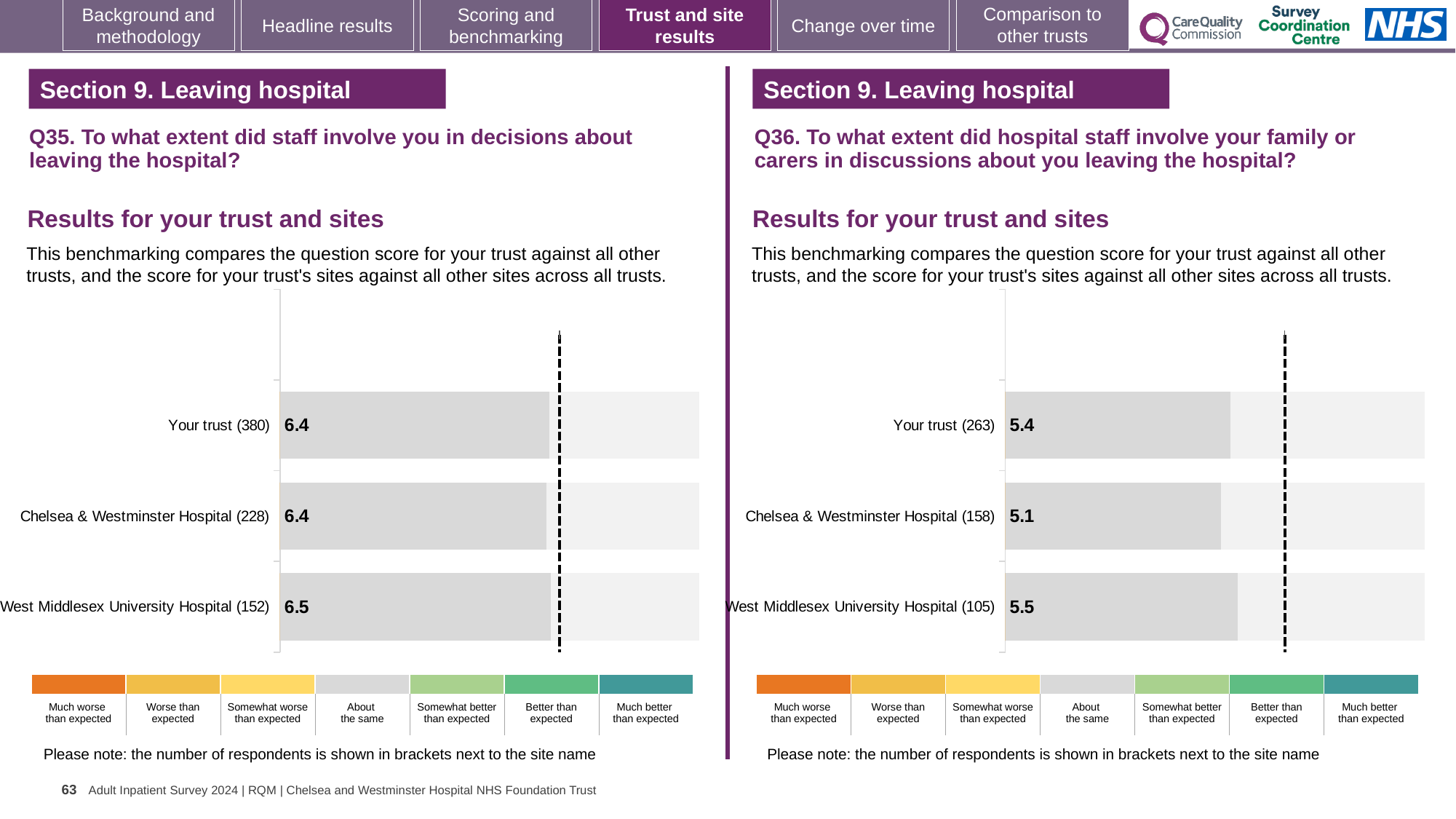
On the Q35 chart (left), which site or trust has the highest score? West Middlesex University Hospital On the Q36 chart (right), what is the score for Chelsea & Westminster Hospital? 5.1 On the Q35 chart (left), what is the score for West Middlesex University Hospital? 6.5 On the Q35 chart (left), what is the score for Your trust? 6.4 On the Q36 chart (right), which site or trust has the highest score? West Middlesex University Hospital On the Q36 chart (right), what is the score for Your trust? 5.4 On the Q35 chart (left), how many respondents are shown in brackets for Your trust? 380 How many bars are plotted on the Q35 chart (left)? 3 On the Q36 chart (right), which has the larger score: Your trust or Chelsea & Westminster Hospital? Your trust What kind of chart is used on the Q36 chart (right)? Bar chart On the Q36 chart (right), which site or trust has the lowest score? Chelsea & Westminster Hospital On the Q36 chart (right), what is the difference between the scores for West Middlesex University Hospital and Chelsea & Westminster Hospital? 0.4